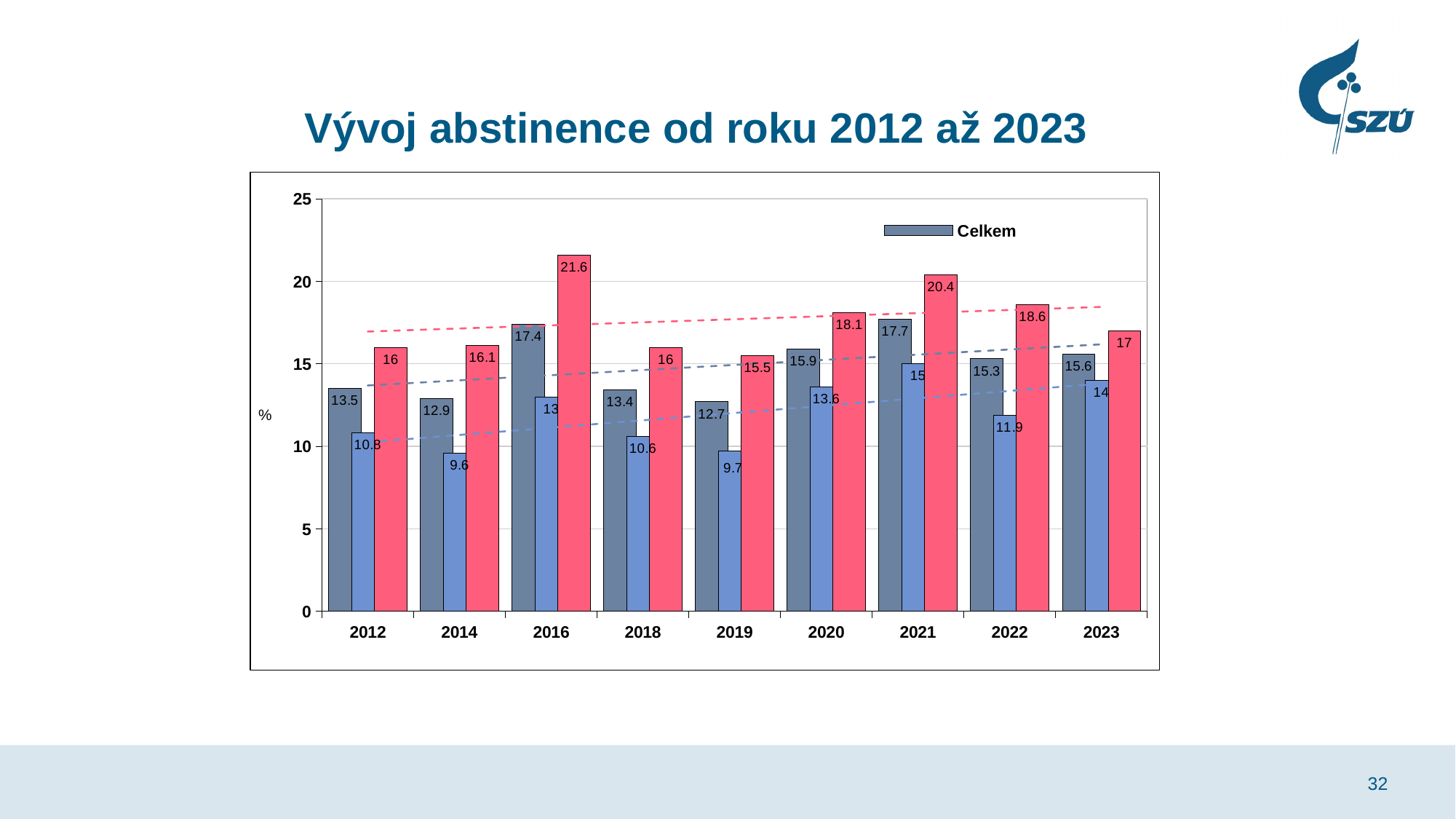
What unit is shown on the y axis label? % What is the value of Celkem for 2021? 17.7 In which year is the Celkem value highest? 2021 How many years are shown on the x axis? 9 How many series does the legend list? 1 What is the title of the slide? Vývoj abstinence od roku 2012 až 2023 What is the value of Celkem for 2023? 15.6 Which year has the larger Celkem value, 2020 or 2022? 2020 What is the difference between the Celkem values for 2021 and 2012? 4.2 What is the value of Celkem for 2012? 13.5 What kind of chart is shown on the slide? bar chart In which year is the Celkem value lowest? 2019